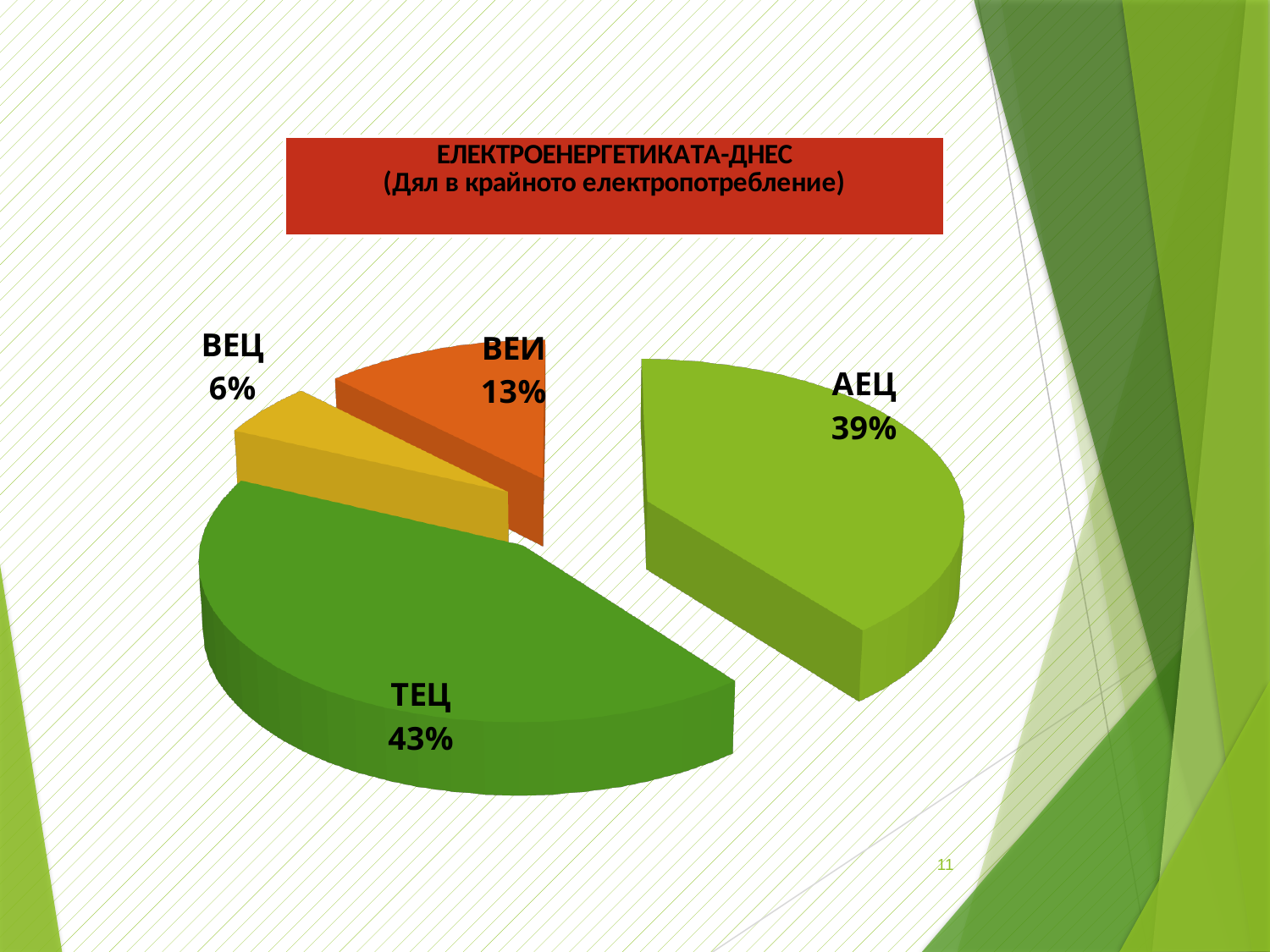
What share of the pie does ТЕЦ have? 43% What share of the pie does ВЕЦ have? 6% Which is larger, the share for ВЕИ or the share for ВЕЦ? ВЕИ What is the difference in percentage points between ВЕИ and ВЕЦ? 7 Which category has the smallest slice of the pie? ВЕЦ What share of the pie does ВЕИ have? 13% What share of the pie does АЕЦ have? 39% What is the difference in percentage points between ТЕЦ and АЕЦ? 4 Which category has the largest slice of the pie? ТЕЦ How many slices does the pie chart have? 4 What kind of chart is shown on the slide? Pie chart What is the title of the chart? ЕЛЕКТРОЕНЕРГЕТИКАТА-ДНЕС (Дял в крайното електропотребление)